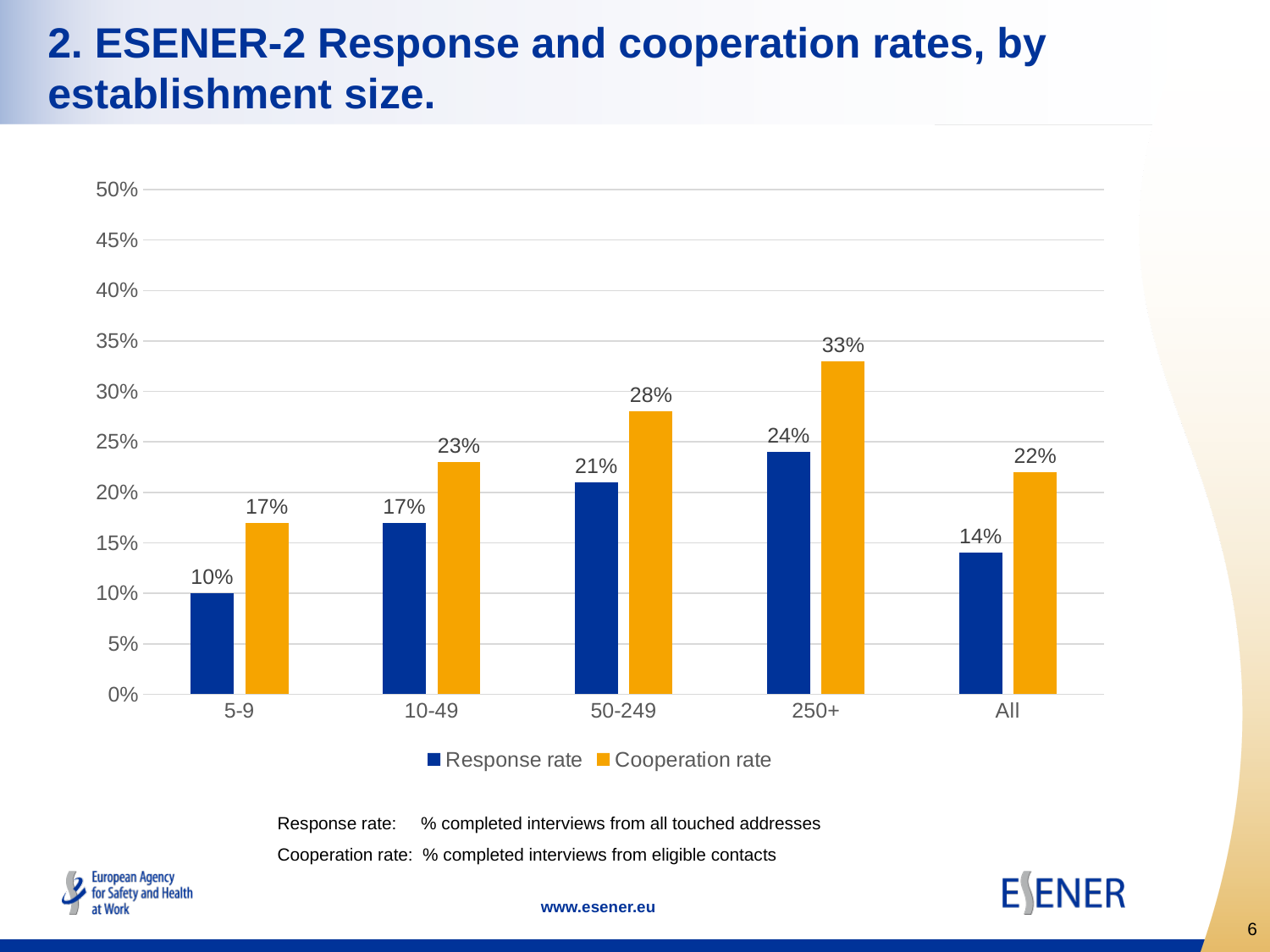
What kind of chart is shown on the slide? Bar chart What is the Cooperation rate for the 'All' category? 22% How many establishment size categories are shown on the x axis? 5 What is the Cooperation rate for establishments of size 250+? 33% How many series does the legend list? 2 Is the Cooperation rate for 250+ greater or less than 30%? greater Which establishment size category has the lowest Cooperation rate? 5-9 Which colour represents the Cooperation rate in the chart? Orange Which is larger: the Response rate for 10-49 or the Response rate for 50-249? 50-249 What is the difference between the Cooperation rate and the Response rate for establishments of size 50-249? 7% Which establishment size category has the highest Response rate? 250+ What is the Response rate for establishments of size 5-9? 10%